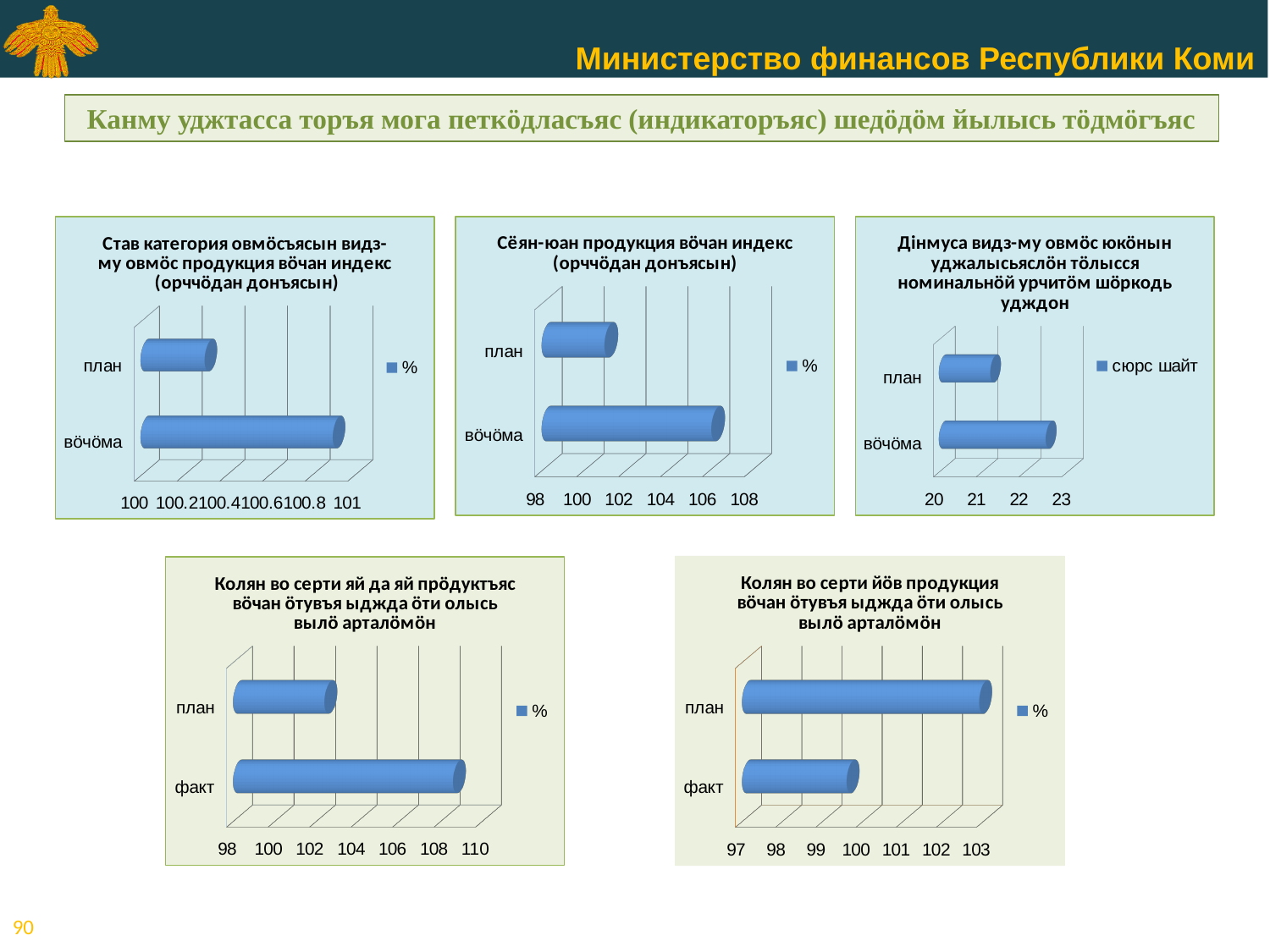
In the top-middle chart, which category is highest? вӧчӧма In the top-left chart, is the value for вӧчӧма greater or less than 100.6? greater In the top-left chart, which category has the longer bar, план or вӧчӧма? вӧчӧма In the top-right chart, which category is lowest? план In the top-right chart, is the value for вӧчӧма greater or less than 22? greater What unit does the legend of the top-right chart show? сюрс шайт In the top-middle chart (Сёян-юан продукция вӧчан индекс), is the value for план greater or less than 104? less How many categories does the top-left chart (Став категория овмӧсъясын...) show? 2 In the bottom-right chart (Колян во серти йӧв продукция...), which category has the larger value, план or факт? план What kind of chart is the top-left chart on the slide? bar chart How many series does the legend of the bottom-right chart list? 1